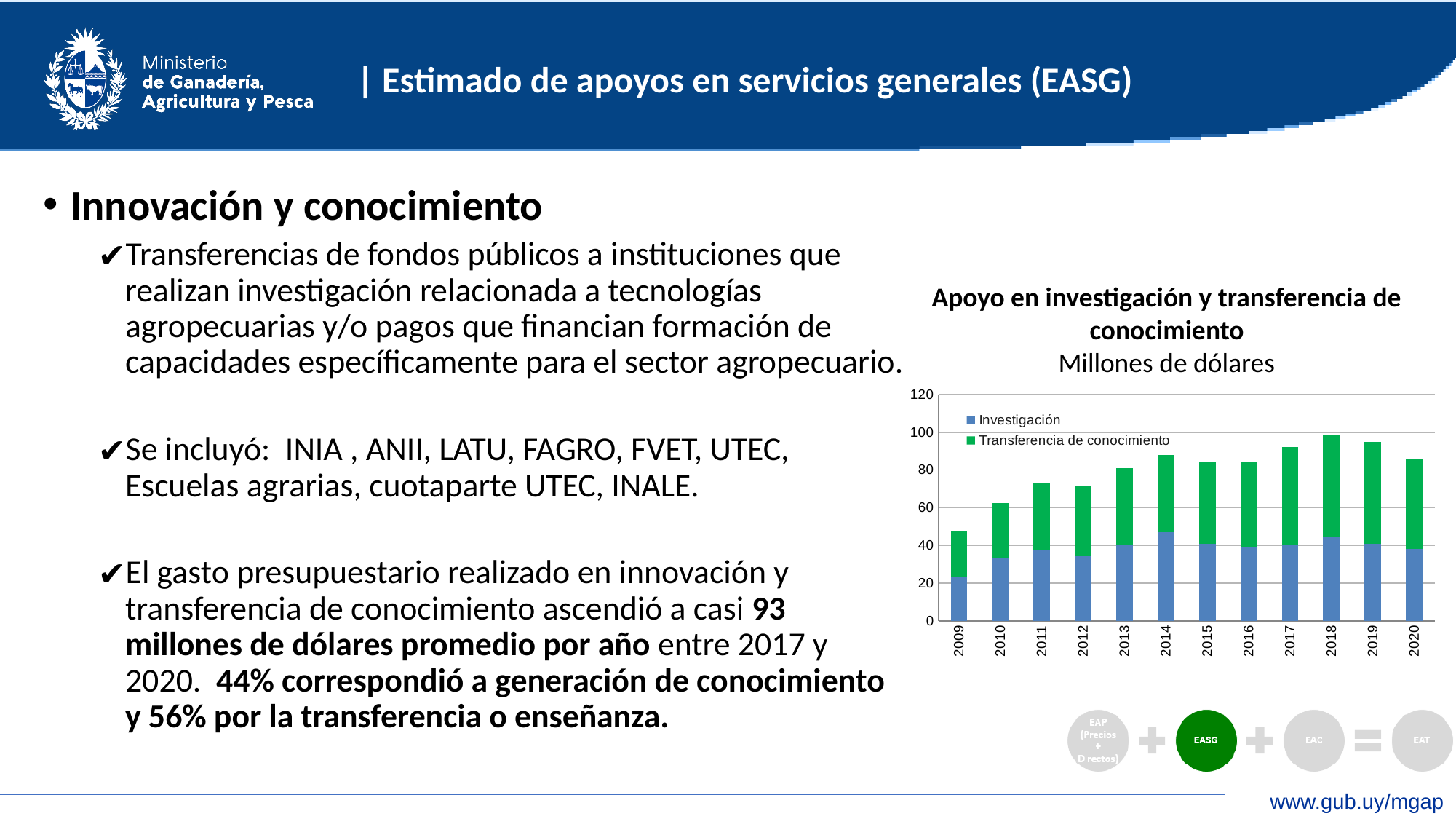
How many years are shown on the x axis of the chart? 12 What kind of chart is shown on the slide? Stacked bar chart Do the total bars rise or fall from 2009 to 2014? Rise Is the total value for 2012 greater or less than 80? less Is the total value for 2009 greater or less than 60? less Which year has the lowest total bar in the chart? 2009 Which colour represents the Investigación series in the chart? Blue Is the total value for 2018 greater or less than 80? greater Which year has the larger total bar, 2013 or 2012? 2013 How many series does the chart legend list? 2 Which year has the highest total bar in the chart? 2018 What unit is stated under the chart title? Millones de dólares